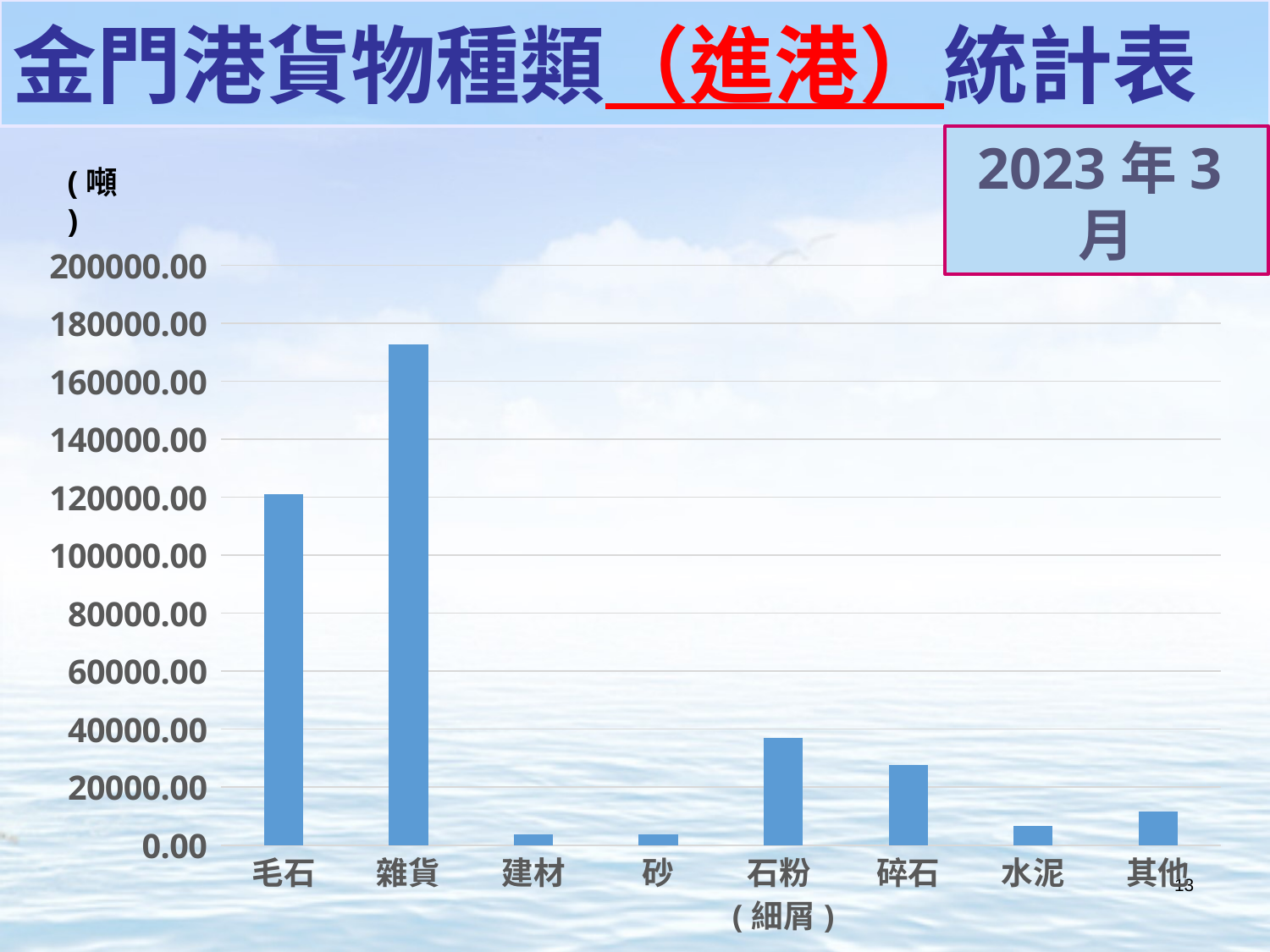
How many cargo categories are shown on the x axis of the chart? 8 What unit is shown for the y axis of the chart? 噸 Which is larger, the value for 毛石 or the value for 雜貨? 雜貨 Is the value for 其他 greater or less than 20000.00? less Which cargo category has the highest value in the chart? 雜貨 What kind of chart is shown on the slide? bar chart Is the value for 毛石 greater or less than 100000.00? greater Is the value for 雜貨 greater or less than 160000.00? greater Which is larger, the value for 石粉（細屑） or the value for 碎石? 石粉（細屑） Which month does the chart's data cover, according to the box on the slide? 2023 年 3 月